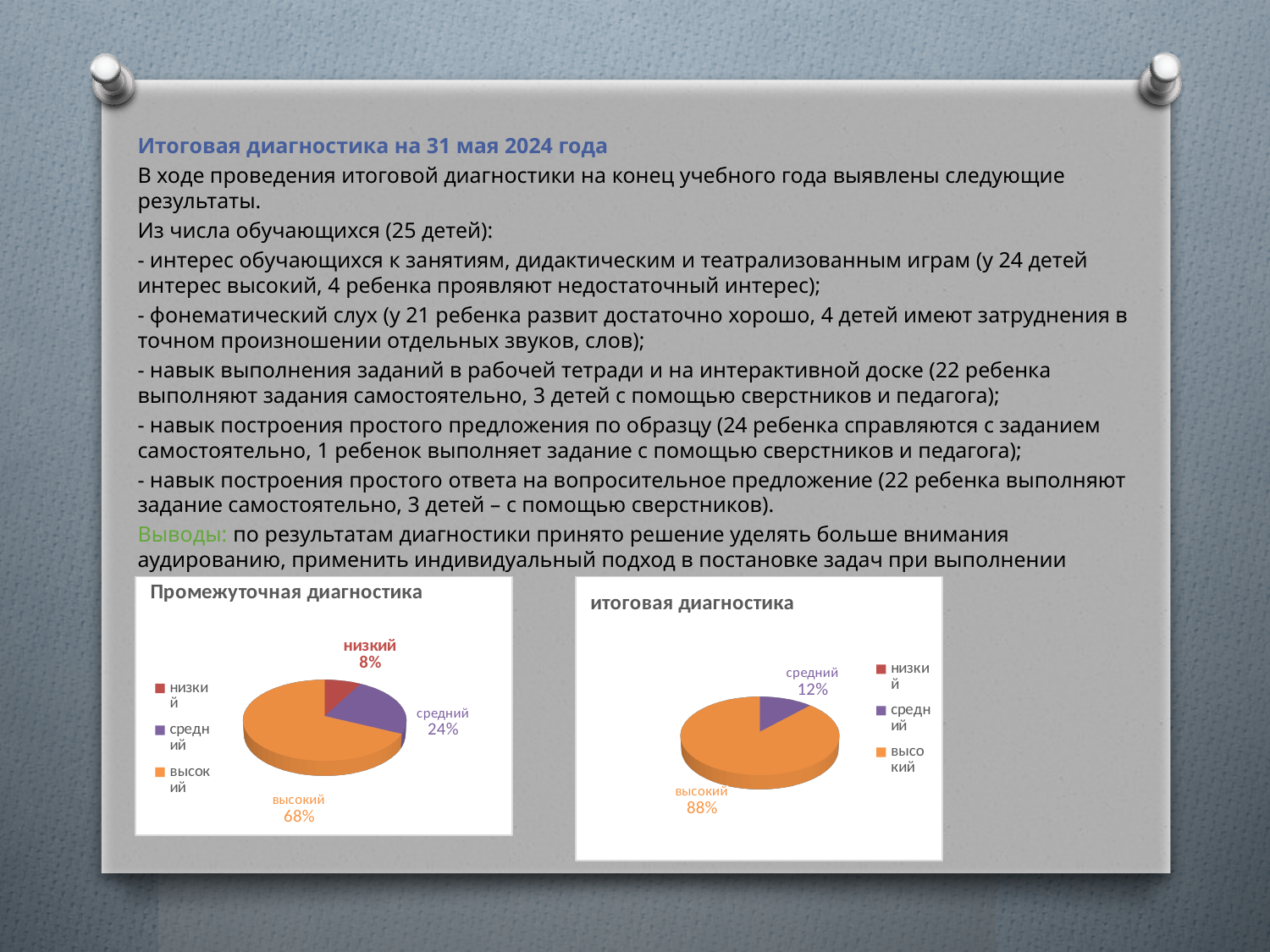
In the chart titled "Промежуточная диагностика", what share does the "средний" slice have? 24% In the chart titled "Промежуточная диагностика", what share does the "высокий" slice have? 68% In the chart titled "Промежуточная диагностика", what share does the "низкий" slice have? 8% In the chart titled "Промежуточная диагностика", which category has the largest slice? высокий Which is larger: the "средний" share in the "Промежуточная диагностика" chart or the "средний" share in the "итоговая диагностика" chart? Промежуточная диагностика In the chart titled "Промежуточная диагностика", which category has the smallest slice? низкий What type of chart is the chart titled "итоговая диагностика"? pie chart In the chart titled "Промежуточная диагностика", what is the difference between the "высокий" and "средний" shares? 44% In the chart titled "итоговая диагностика", what is the difference between the "высокий" and "средний" shares? 76% How many entries does the legend of the chart titled "итоговая диагностика" list? 3